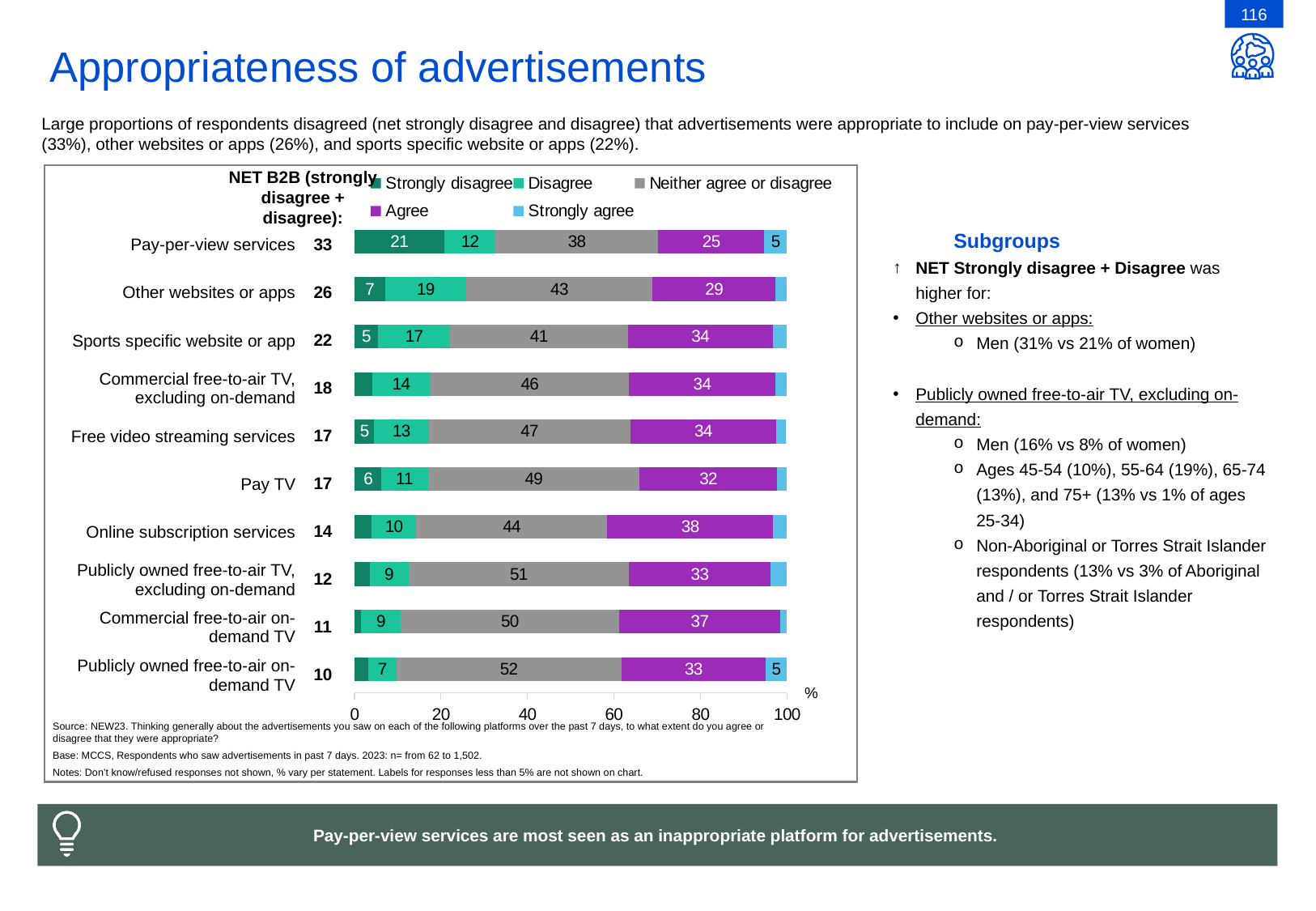
What type of chart is shown on the slide? Stacked bar chart What is the 'Agree' value for Online subscription services? 38 What percentage of respondents selected 'Neither agree or disagree' for Pay-per-view services? 38 What is the difference between the 'Disagree' values for Other websites or apps and Pay TV? 8 Which has a larger 'Agree' value: Commercial free-to-air on-demand TV or Pay TV? Commercial free-to-air on-demand TV Which legend entry is shown in purple? Agree What is the 'Strongly disagree' value for Pay-per-view services? 21 Which platform has the lowest NET B2B (strongly disagree + disagree) value? Publicly owned free-to-air on-demand TV How many series does the chart legend list? 5 Which platform has the highest 'Neither agree or disagree' value? Publicly owned free-to-air on-demand TV What is the NET B2B (strongly disagree + disagree) value for Other websites or apps? 26 How many platforms are shown in the chart? 10